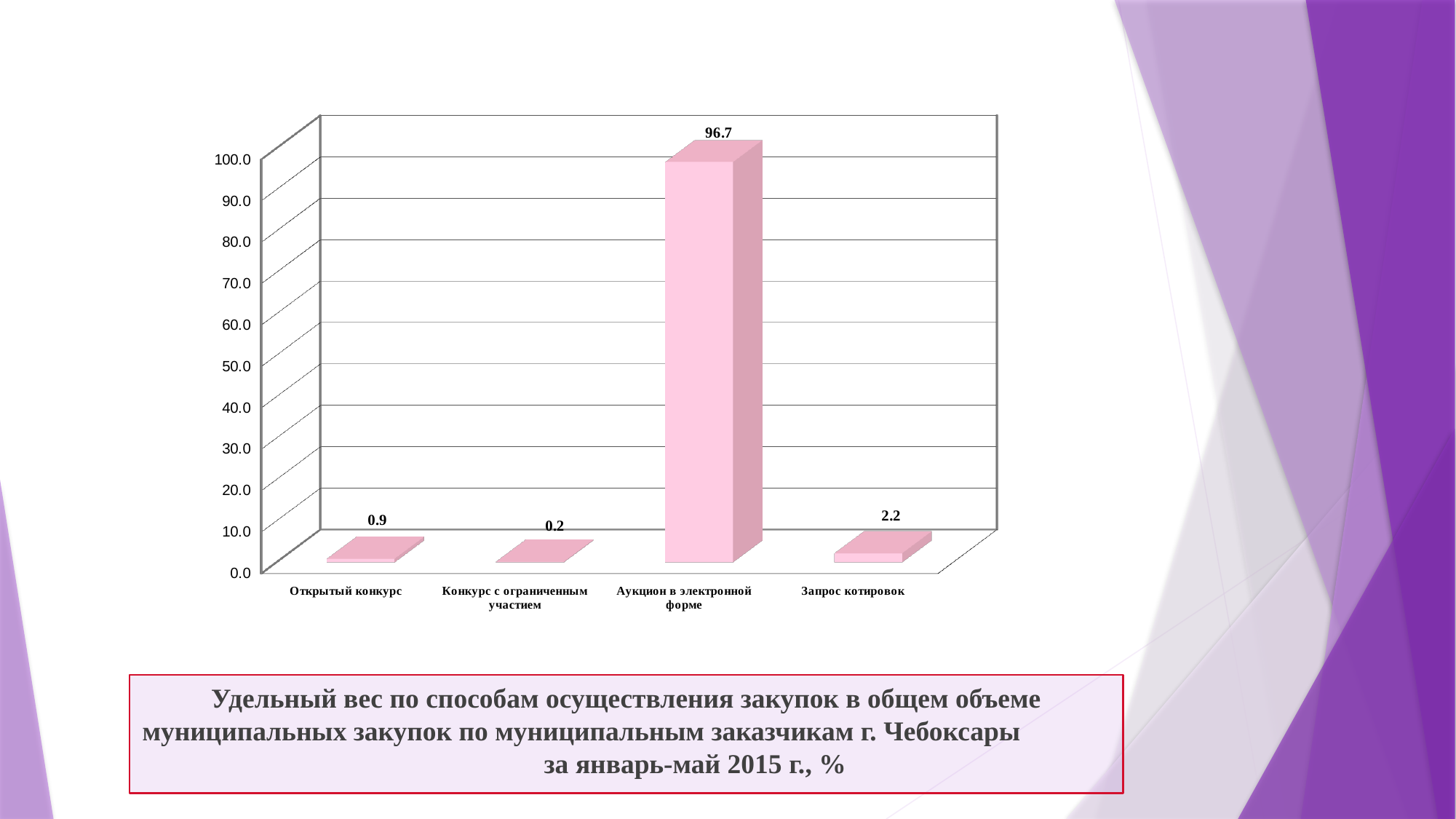
Is the value for Аукцион в электронной форме greater or less than 90.0? greater What is the value for Запрос котировок? 2.2 What is the value for Открытый конкурс? 0.9 What kind of chart is shown on the slide? bar chart What is the difference between the values for Аукцион в электронной форме and Запрос котировок? 94.5 What is the value for Аукцион в электронной форме? 96.7 Which category has the highest value? Аукцион в электронной форме Which is larger, the value for Запрос котировок or the value for Открытый конкурс? Запрос котировок What is the value for Конкурс с ограниченным участием? 0.2 What is the difference between the values for Запрос котировок and Открытый конкурс? 1.3 How many categories are shown on the x axis? 4 Which category has the lowest value? Конкурс с ограниченным участием